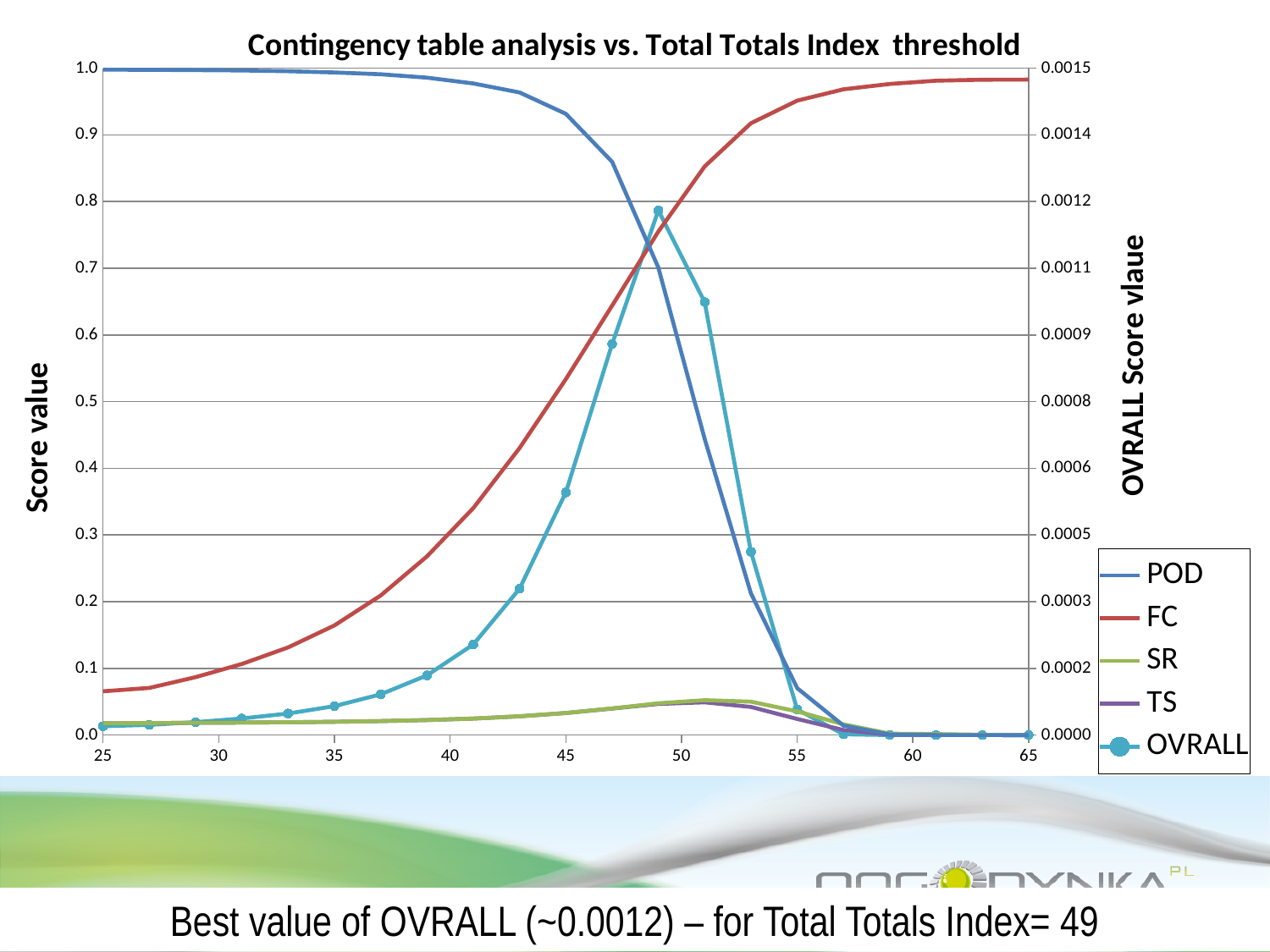
How many series does the legend list? 5 At a threshold of 45, which series has the higher value, POD or FC? POD What kind of chart is shown on the slide? line chart Which series is plotted against the right-hand axis labelled 'OVRALL Score vlaue'? OVRALL Is the POD value at a threshold of 35 greater or less than 0.9? greater Does the POD series rise or fall as the Total Totals Index threshold increases from 25 to 65? fall At which Total Totals Index threshold does the OVRALL series reach its highest value? 49 Is the FC value at a threshold of 60 greater or less than 0.9? greater Does the FC series rise or fall as the Total Totals Index threshold increases from 25 to 65? rise At a threshold of 55, which series has the higher value, POD or FC? FC Is the FC value at a threshold of 25 greater or less than 0.1? less What is the title of the chart? Contingency table analysis vs. Total Totals Index threshold